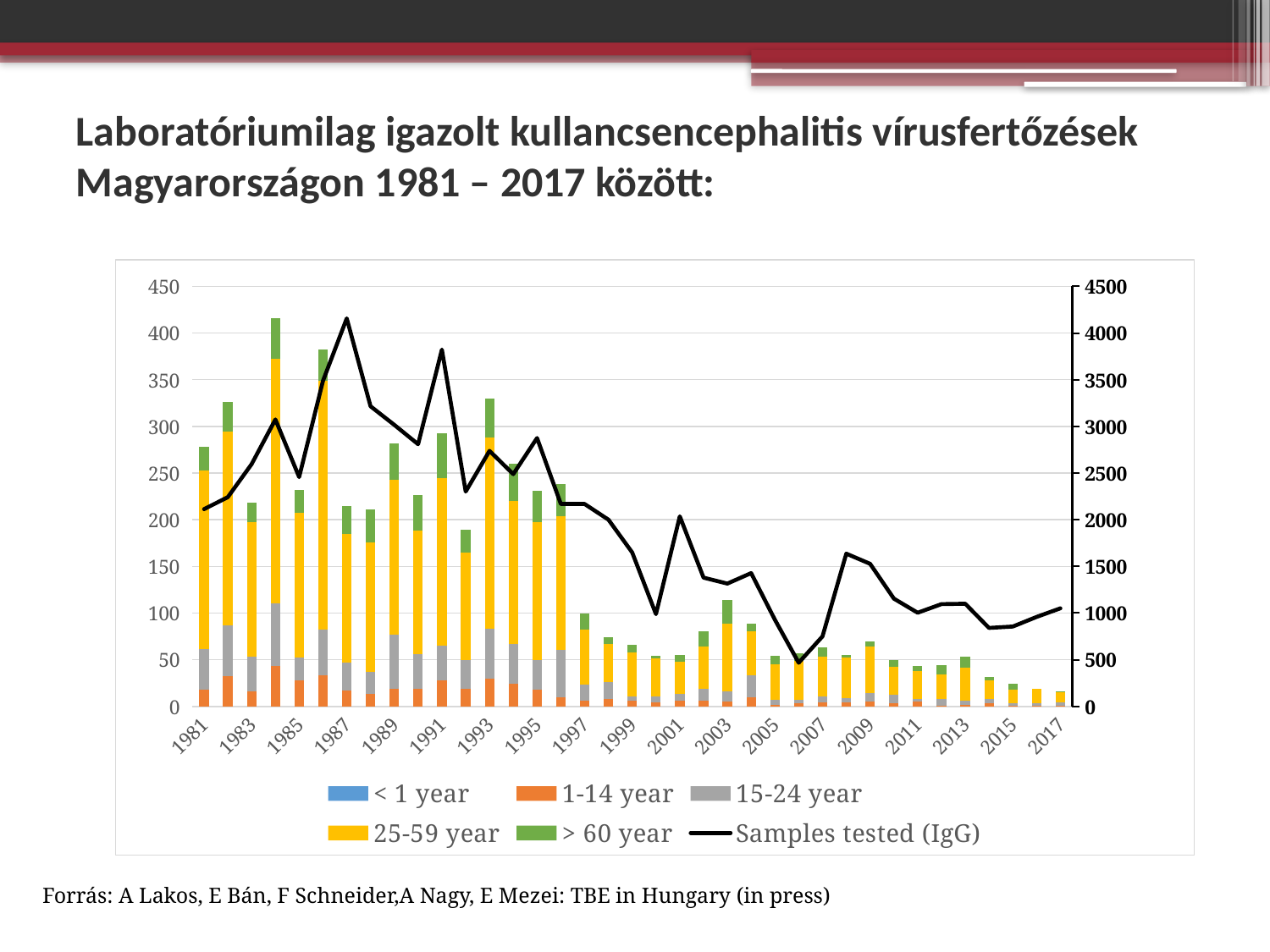
How many series does the legend list? 6 Is the total of the stacked bar for 2017 greater or less than 50? less Is the Samples tested (IgG) value for 1987 greater or less than 4000? greater Which year has the taller stacked bar, 1981 or 1982? 1982 What is the maximum value shown on the right-hand axis? 4500 In which year does the Samples tested (IgG) line reach its lowest point? 2006 In which year does the Samples tested (IgG) line reach its highest point? 1987 Does the Samples tested (IgG) line generally rise or fall from 1987 to 2017? fall Is the total of the stacked bar for 1984 greater or less than 400? greater Which year has the tallest stacked bar? 1984 What kind of chart is shown on the slide? stacked bar chart with a line